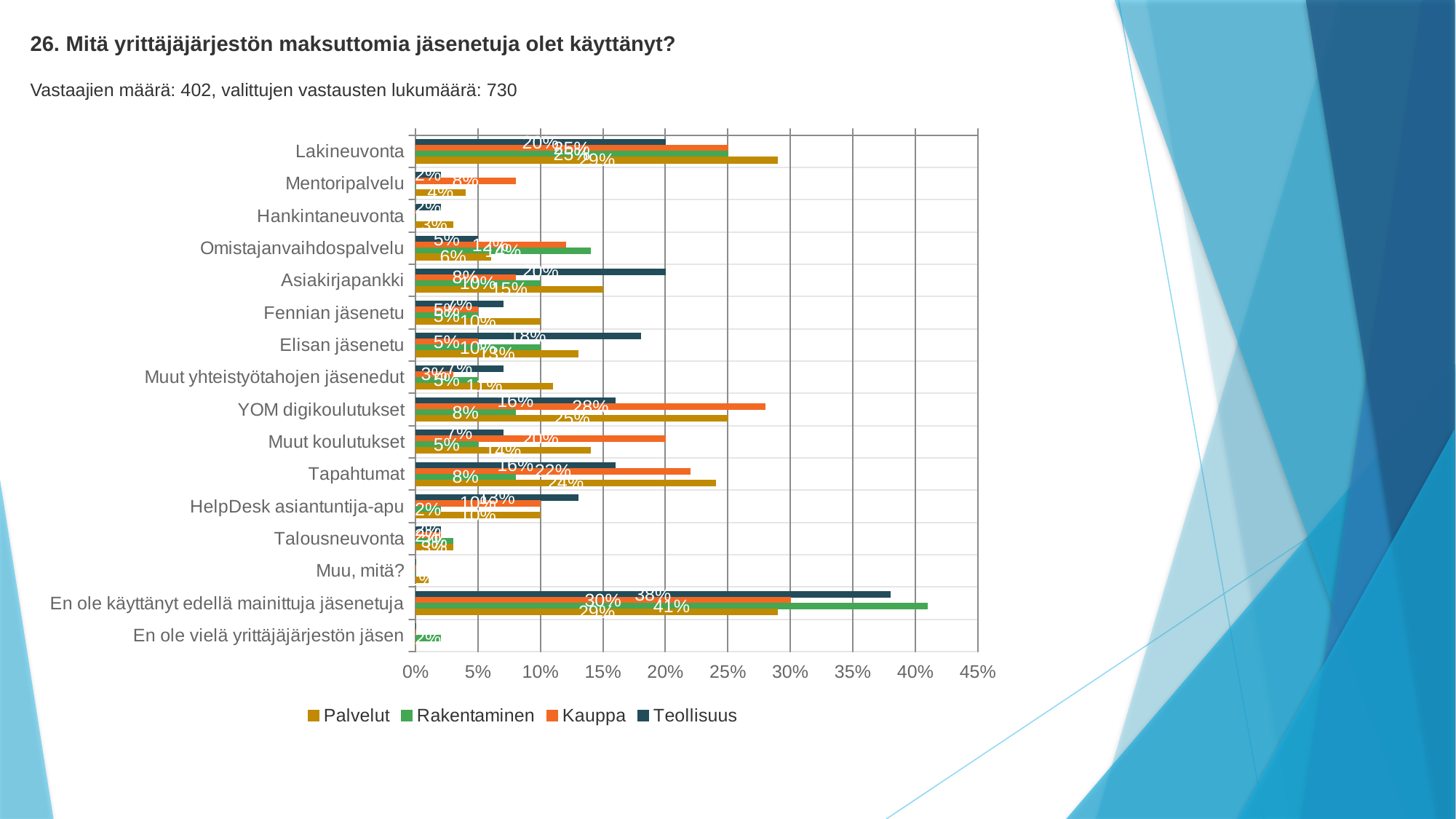
How many series does the legend list? 4 What is the Palvelut value for 'Tapahtumat'? 24% For 'Tapahtumat', which is larger: the Palvelut value or the Kauppa value? Palvelut Which series has the lowest value for 'YOM digikoulutukset'? Rakentaminen What is the Rakentaminen value for 'En ole käyttänyt edellä mainittuja jäsenetuja'? 41% What kind of chart is shown on the slide? bar chart How many categories are shown on the vertical axis of the chart? 16 Is the Teollisuus value for 'Elisan jäsenetu' greater or less than 15%? greater Which series has the highest value for 'En ole käyttänyt edellä mainittuja jäsenetuja'? Rakentaminen What is the Teollisuus value for 'En ole käyttänyt edellä mainittuja jäsenetuja'? 38% What is the difference between the Kauppa and Rakentaminen values for 'YOM digikoulutukset'? 20% What is the Kauppa value for 'YOM digikoulutukset'? 28%